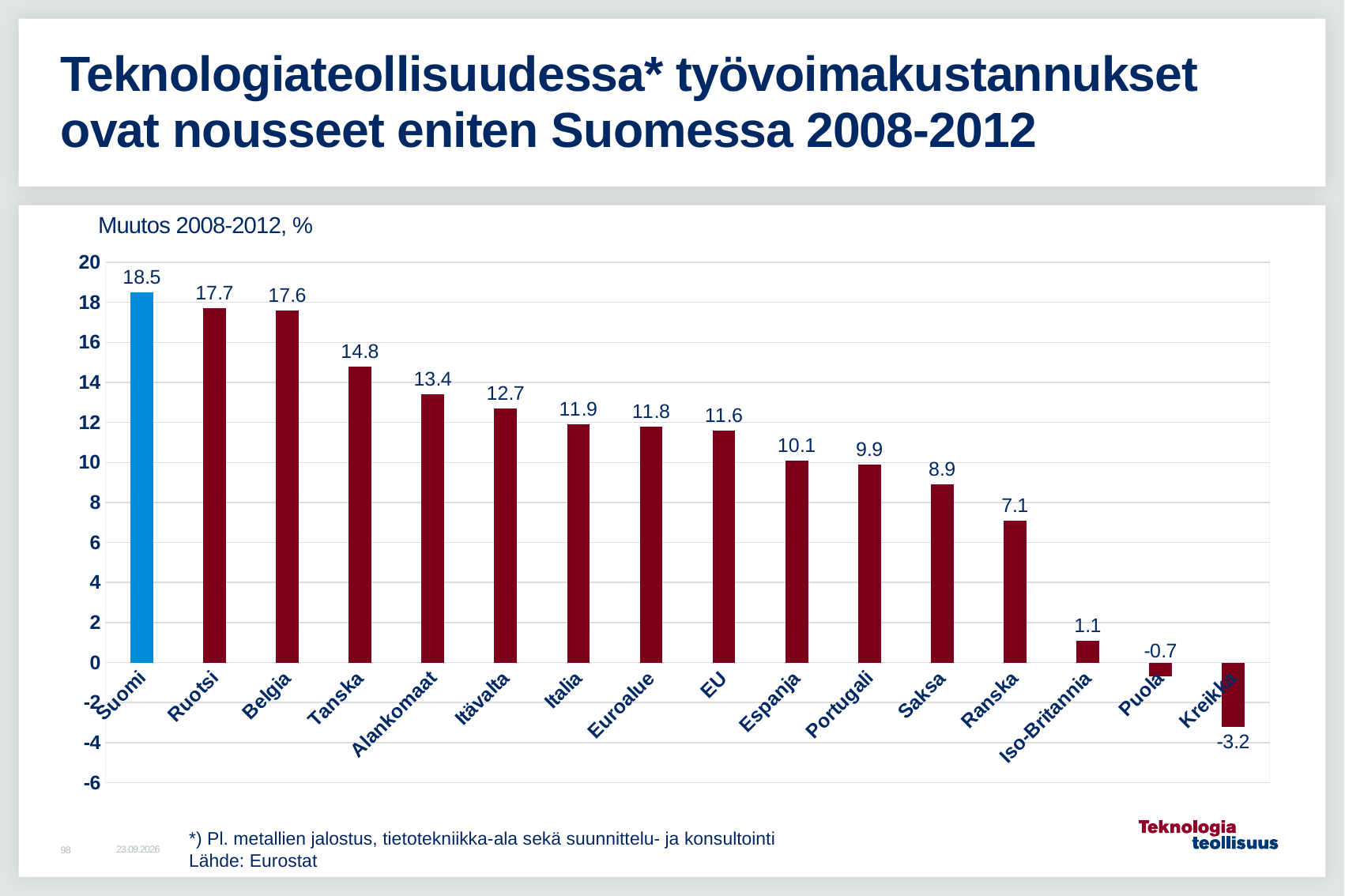
What is the value for Saksa? 8.9 What is the difference between the values for Suomi and Ruotsi? 0.8 How many categories are shown on the x axis? 16 What is the value for Suomi? 18.5 What is the value for Kreikka? -3.2 What is the difference between the values for Tanska and Ranska? 7.7 Which country has the highest value? Suomi Do the values generally rise or fall from left to right along the x axis? Fall Which category has the lowest value? Kreikka What kind of chart is shown on the slide? Bar chart What is the value for Alankomaat? 13.4 Which is larger, the value for Espanja or the value for Portugali? Espanja